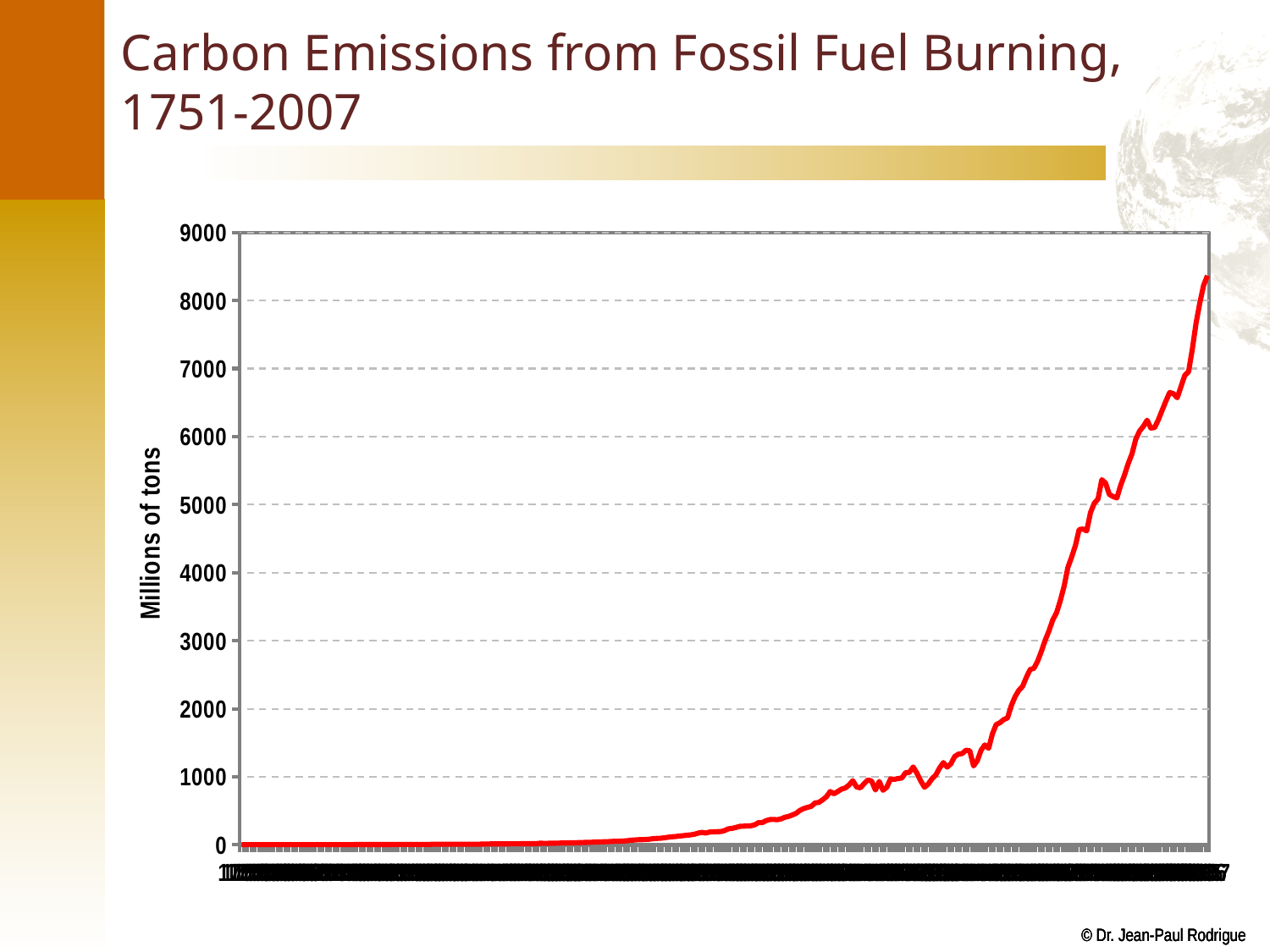
What is the label on the vertical axis of the chart? Millions of tons Which end of the line is higher, the left-hand start or the right-hand end? the right-hand end What is the title of the chart on the slide? Carbon Emissions from Fossil Fuel Burning, 1751-2007 Is the value at the right-hand end of the line greater or less than 8000? greater Is the value at the midpoint of the x axis greater or less than 1000? less How many data series are plotted on the chart? 1 Is the value at the left-hand start of the line greater or less than 1000? less Do the values on the chart generally rise or fall from left to right along the x axis? rise What is the highest tick value shown on the vertical axis? 9000 What kind of chart is shown on the slide? line chart